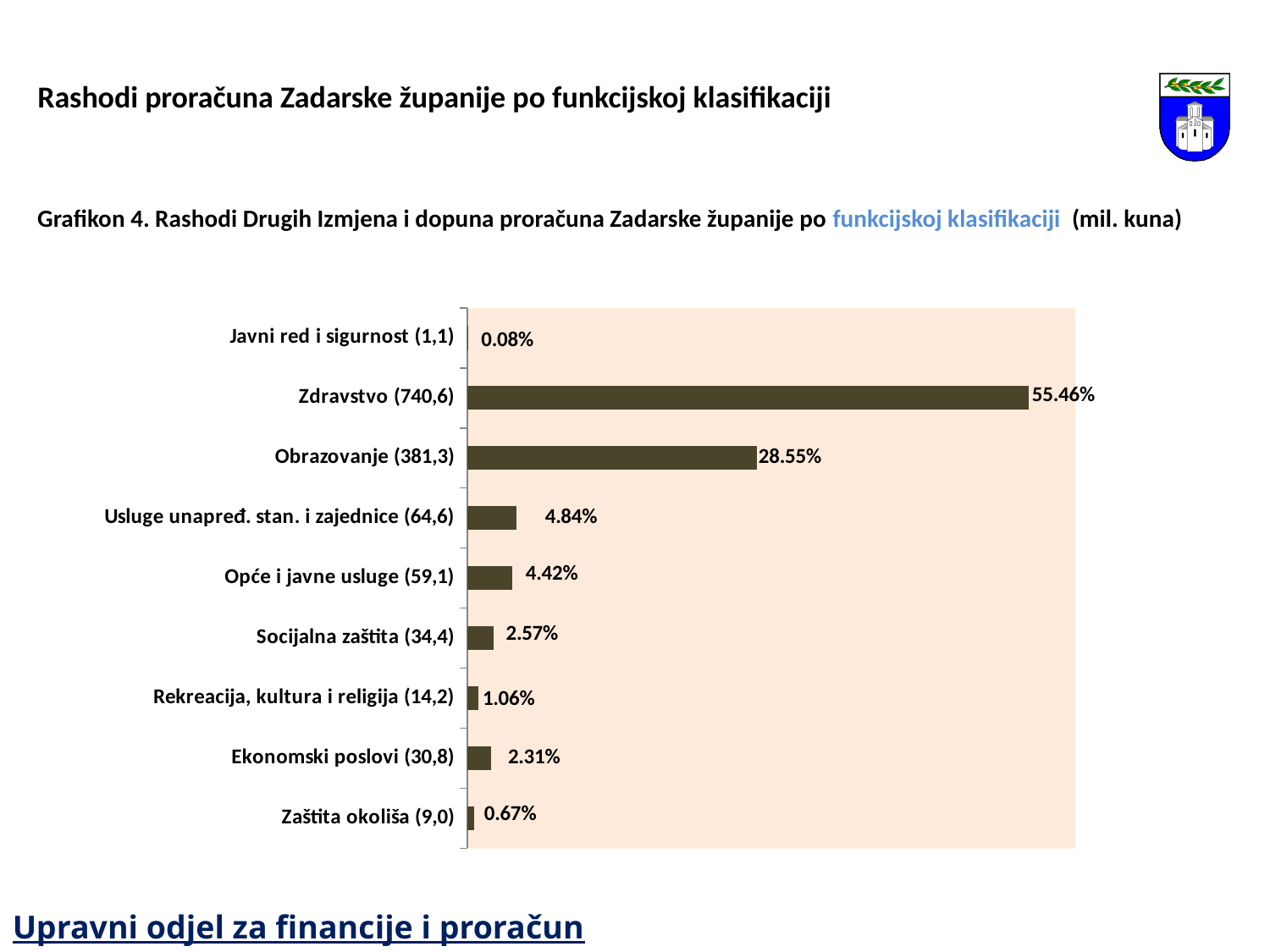
Which category has the lowest percentage? Javni red i sigurnost (1,1) What is the difference in percentage points between Zdravstvo (740,6) and Obrazovanje (381,3)? 26.91 What percentage is shown for Zaštita okoliša (9,0)? 0.67% What percentage is shown for Socijalna zaštita (34,4)? 2.57% Which has a larger percentage, Usluge unapređ. stan. i zajednice (64,6) or Opće i javne usluge (59,1)? Usluge unapređ. stan. i zajednice (64,6) Which has a larger percentage, Ekonomski poslovi (30,8) or Rekreacija, kultura i religija (14,2)? Ekonomski poslovi (30,8) How many categories are shown in the chart? 9 Which category has the highest percentage? Zdravstvo (740,6) What percentage is shown for Obrazovanje (381,3)? 28.55% What unit is stated in the chart title for the values in parentheses? mil. kuna What percentage is shown for Zdravstvo (740,6)? 55.46% What kind of chart is shown on the slide? Bar chart